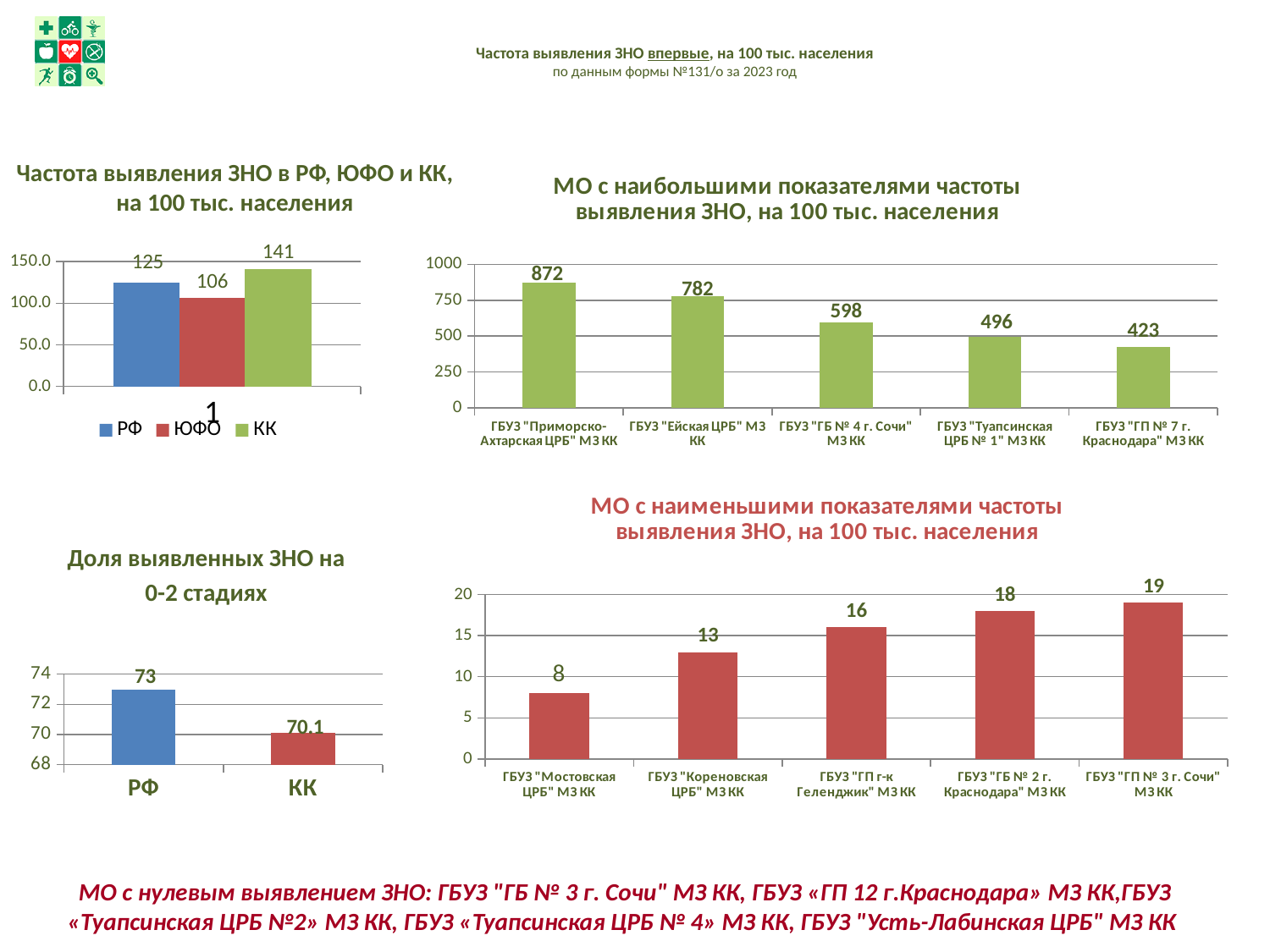
What kind of chart is 'МО с наименьшими показателями частоты выявления ЗНО, на 100 тыс. населения'? bar chart On the chart 'МО с наибольшими показателями частоты выявления ЗНО, на 100 тыс. населения', do the values rise or fall from left to right? fall On the chart 'Частота выявления ЗНО в РФ, ЮФО и КК, на 100 тыс. населения', which series has the lowest value? ЮФО On the chart 'МО с наименьшими показателями частоты выявления ЗНО, на 100 тыс. населения', what is the value for ГБУЗ "ГП г-к Геленджик" МЗ КК? 16 On the chart 'Частота выявления ЗНО в РФ, ЮФО и КК, на 100 тыс. населения', what is the difference between the values for КК and РФ? 16 On the chart 'Частота выявления ЗНО в РФ, ЮФО и КК, на 100 тыс. населения', what is the value for КК? 141 On the chart 'МО с наибольшими показателями частоты выявления ЗНО, на 100 тыс. населения', which organisation has the highest value? ГБУЗ "Приморско-Ахтарская ЦРБ" МЗ КК On the chart 'МО с наибольшими показателями частоты выявления ЗНО, на 100 тыс. населения', what is the value for ГБУЗ "Ейская ЦРБ" МЗ КК? 782 On the chart 'Доля выявленных ЗНО на 0-2 стадиях', what is the value for КК? 70.1 On the chart 'Доля выявленных ЗНО на 0-2 стадиях', which is larger, the value for РФ or for КК? РФ On the chart 'МО с наибольшими показателями частоты выявления ЗНО, на 100 тыс. населения', how many organisations are shown? 5 On the chart 'Частота выявления ЗНО в РФ, ЮФО и КК, на 100 тыс. населения', how many series does the legend list? 3